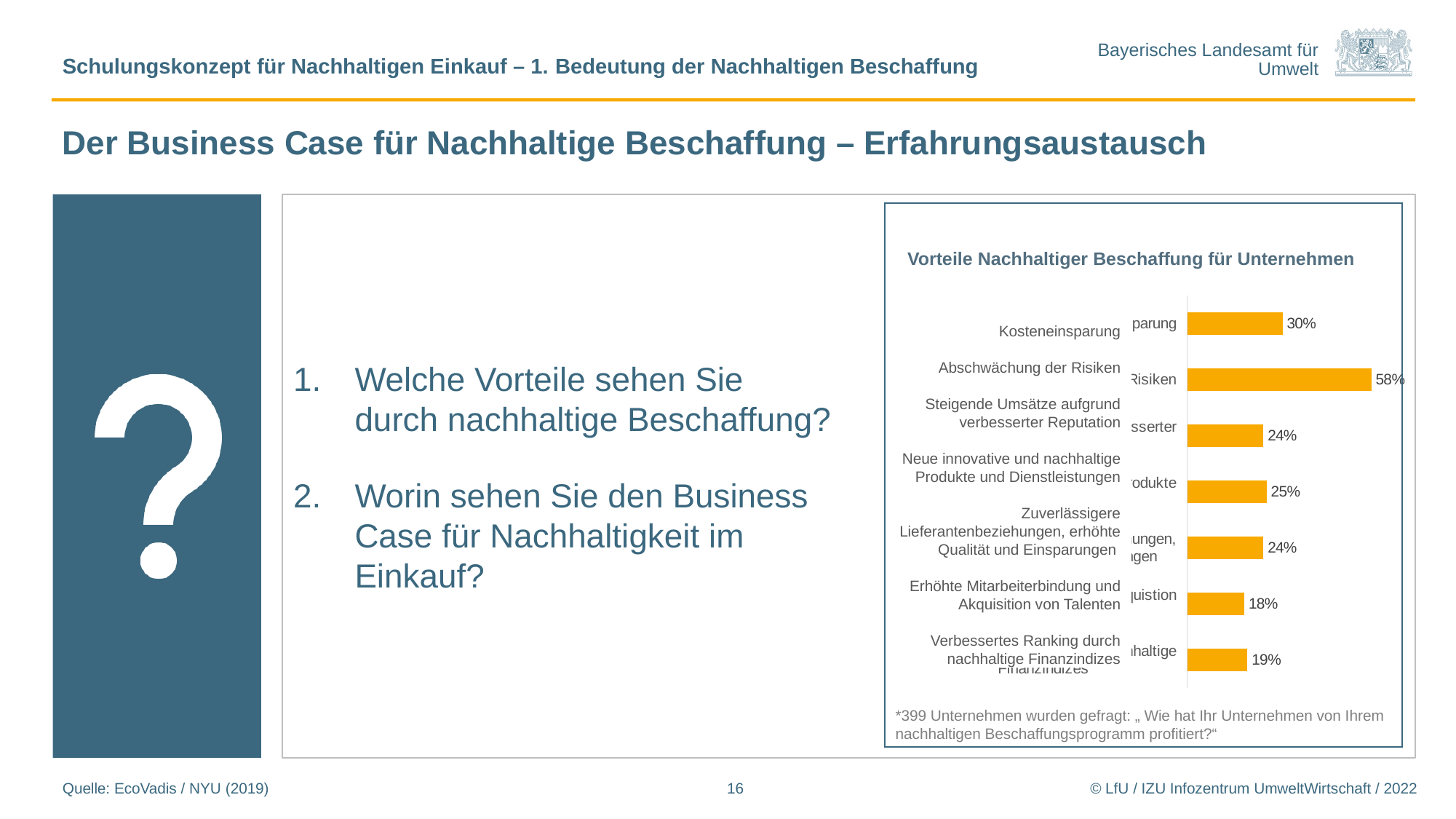
What is the difference between the values for Abschwächung der Risiken and Kosteneinsparung? 28% What is the title of the chart? Vorteile Nachhaltiger Beschaffung für Unternehmen Which category has the highest value? Abschwächung der Risiken How many categories are shown in the chart? 7 What value is shown for Erhöhte Mitarbeiterbindung und Akquisition von Talenten? 18% What value is shown for Abschwächung der Risiken? 58% What value is shown for Kosteneinsparung? 30% Which is larger: the value for Kosteneinsparung or the value for Neue innovative und nachhaltige Produkte und Dienstleistungen? Kosteneinsparung What kind of chart is shown on the slide? Bar chart What colour are the bars in the chart? Orange What value is shown for Verbessertes Ranking durch nachhaltige Finanzindizes? 19% Which category has the lowest value? Erhöhte Mitarbeiterbindung und Akquisition von Talenten